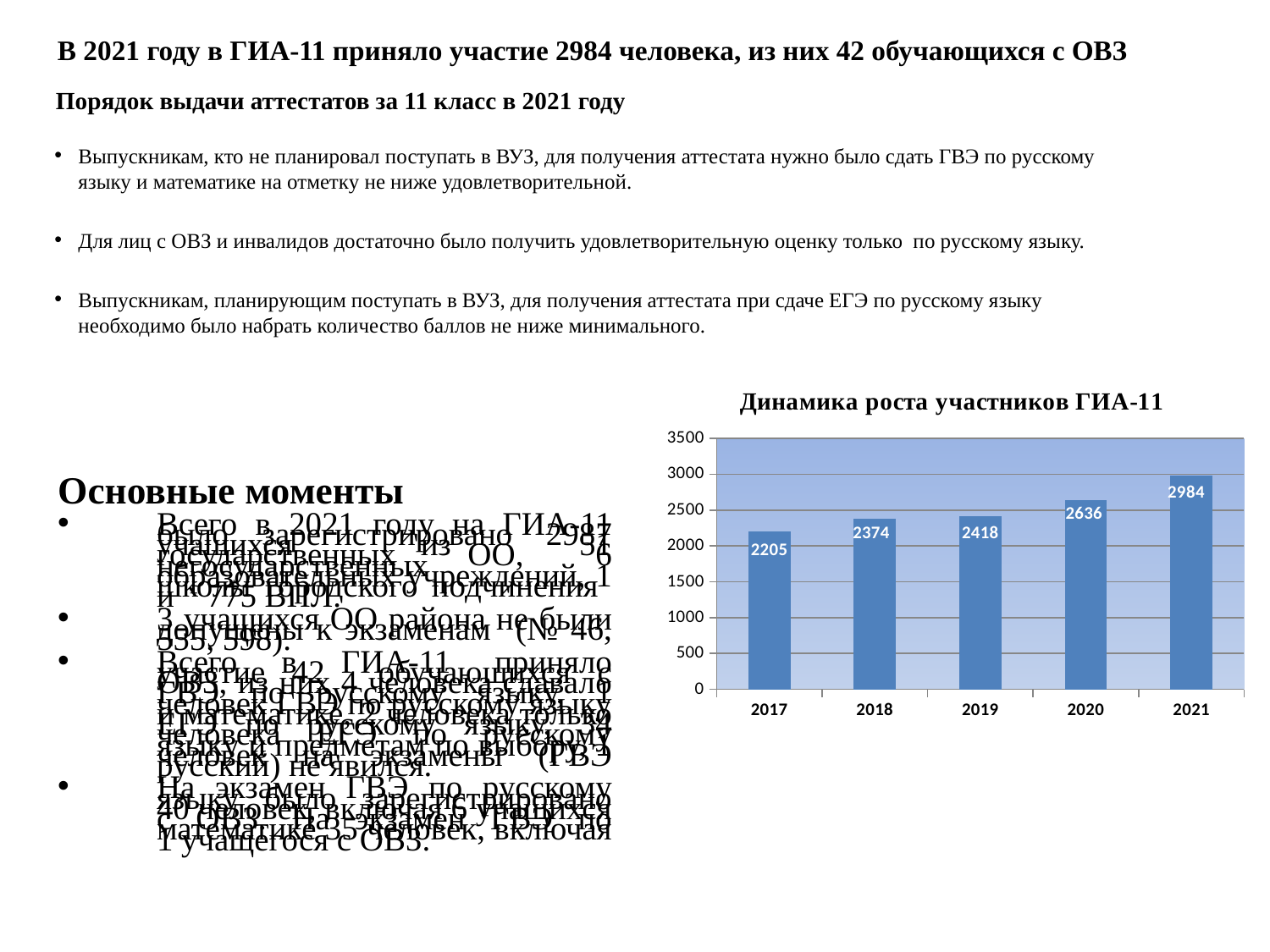
What is the value for 2017 in the chart 'Динамика роста участников ГИА-11'? 2205 Is the value for 2020 in the chart 'Динамика роста участников ГИА-11' greater or less than 2500? greater Which year has the highest value in the chart 'Динамика роста участников ГИА-11'? 2021 Do the values in the chart 'Динамика роста участников ГИА-11' rise or fall from 2017 to 2021? rise What is the value for 2021 in the chart 'Динамика роста участников ГИА-11'? 2984 What is the difference between the values for 2018 and 2017 in the chart 'Динамика роста участников ГИА-11'? 169 What is the value for 2019 in the chart 'Динамика роста участников ГИА-11'? 2418 What kind of chart is 'Динамика роста участников ГИА-11'? bar chart Which is larger in the chart 'Динамика роста участников ГИА-11': the value for 2019 or the value for 2020? 2020 What is the difference between the values for 2021 and 2020 in the chart 'Динамика роста участников ГИА-11'? 348 Which year has the lowest value in the chart 'Динамика роста участников ГИА-11'? 2017 How many years are shown on the x axis of the chart 'Динамика роста участников ГИА-11'? 5